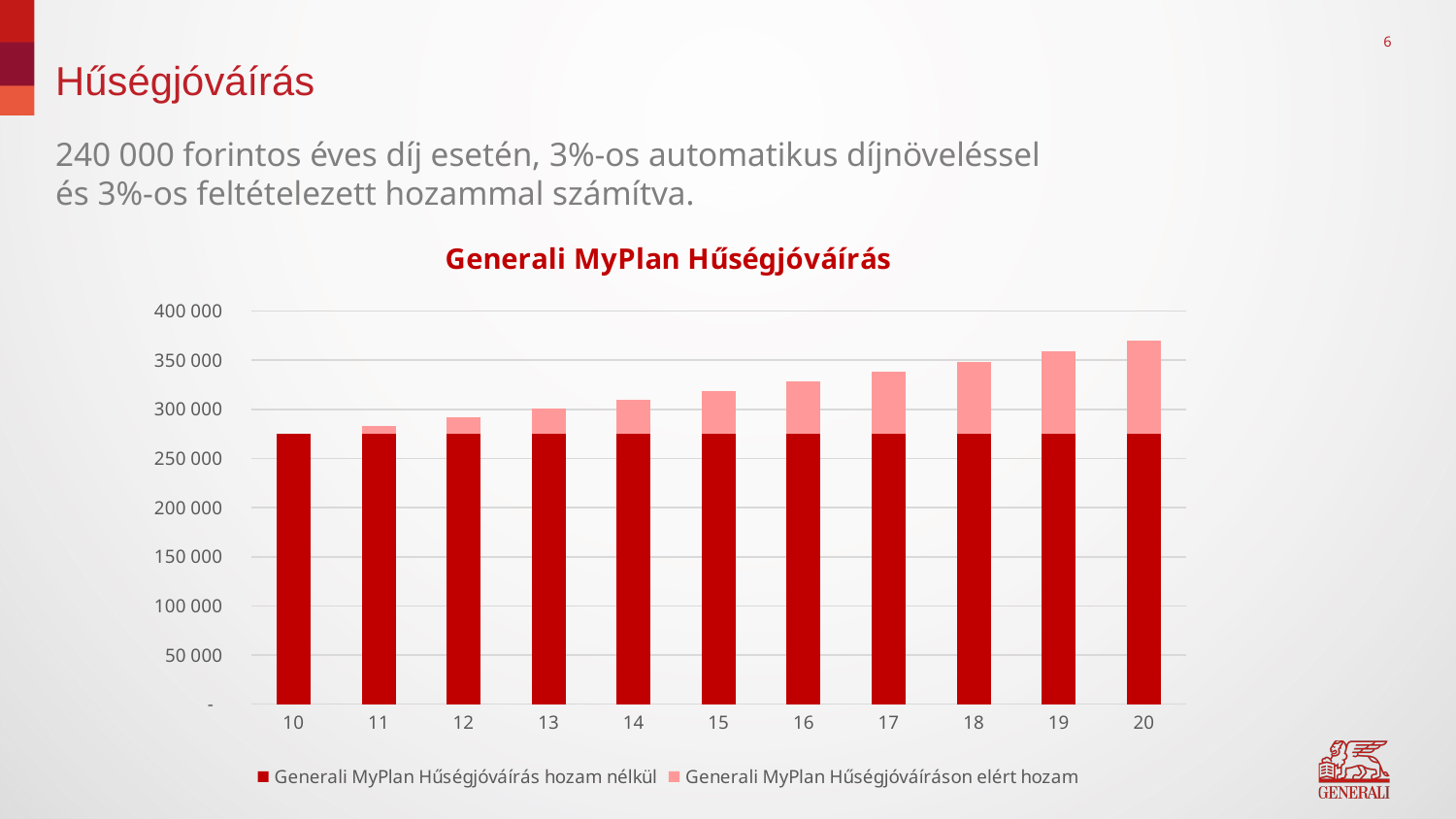
Is the total bar for year 18 taller or shorter than the total bar for year 12? taller Which legend entry is shown in light pink? Generali MyPlan Hűségjóváíráson elért hozam How many categories (years) are shown on the x axis? 11 How many series does the legend list? 2 Is the total value for year 20 greater or less than 350 000? greater Is the total value for year 17 greater or less than 300 000? greater Do the total bar heights rise or fall from year 10 to year 20? rise Which year has the highest total bar? 20 Is the total value for year 10 greater or less than 300 000? less What is the title of the chart? Generali MyPlan Hűségjóváírás Which year has the lowest total bar? 10 What kind of chart is shown on the slide? bar chart